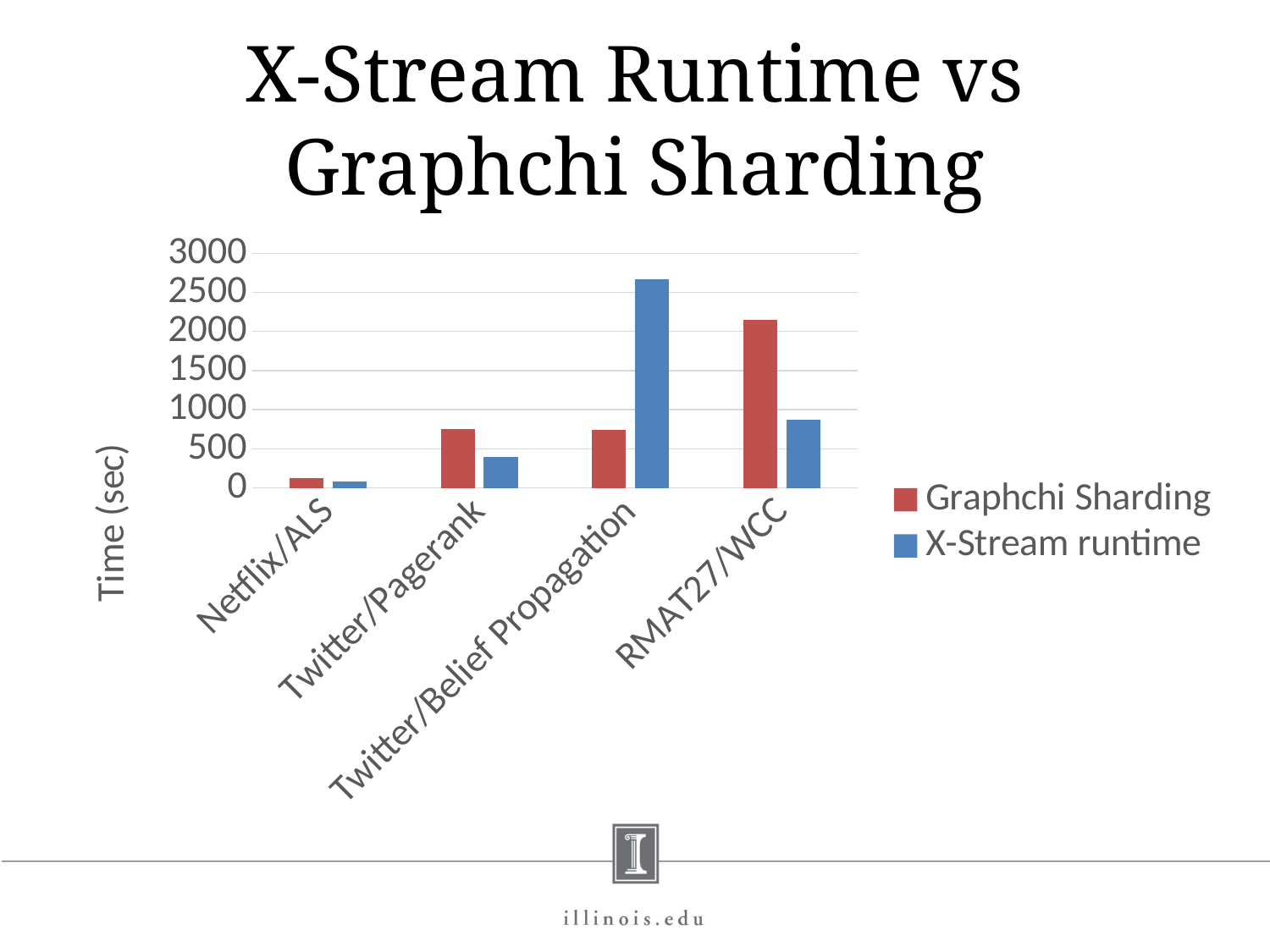
Is the Graphchi Sharding value for RMAT27/WCC greater or less than 2000? greater What is the label on the vertical axis of the chart? Time (sec) For RMAT27/WCC, which is larger: Graphchi Sharding or X-Stream runtime? Graphchi Sharding Which category has the highest X-Stream runtime? Twitter/Belief Propagation What kind of chart is shown on the slide? bar chart Which category has the lowest X-Stream runtime? Netflix/ALS How many categories are shown on the x axis of the chart? 4 Is the X-Stream runtime for Twitter/Belief Propagation greater or less than 2500? greater How many series does the chart's legend list? 2 For Twitter/Belief Propagation, which is larger: Graphchi Sharding or X-Stream runtime? X-Stream runtime Which category has the highest Graphchi Sharding time? RMAT27/WCC Which category has the lowest Graphchi Sharding time? Netflix/ALS